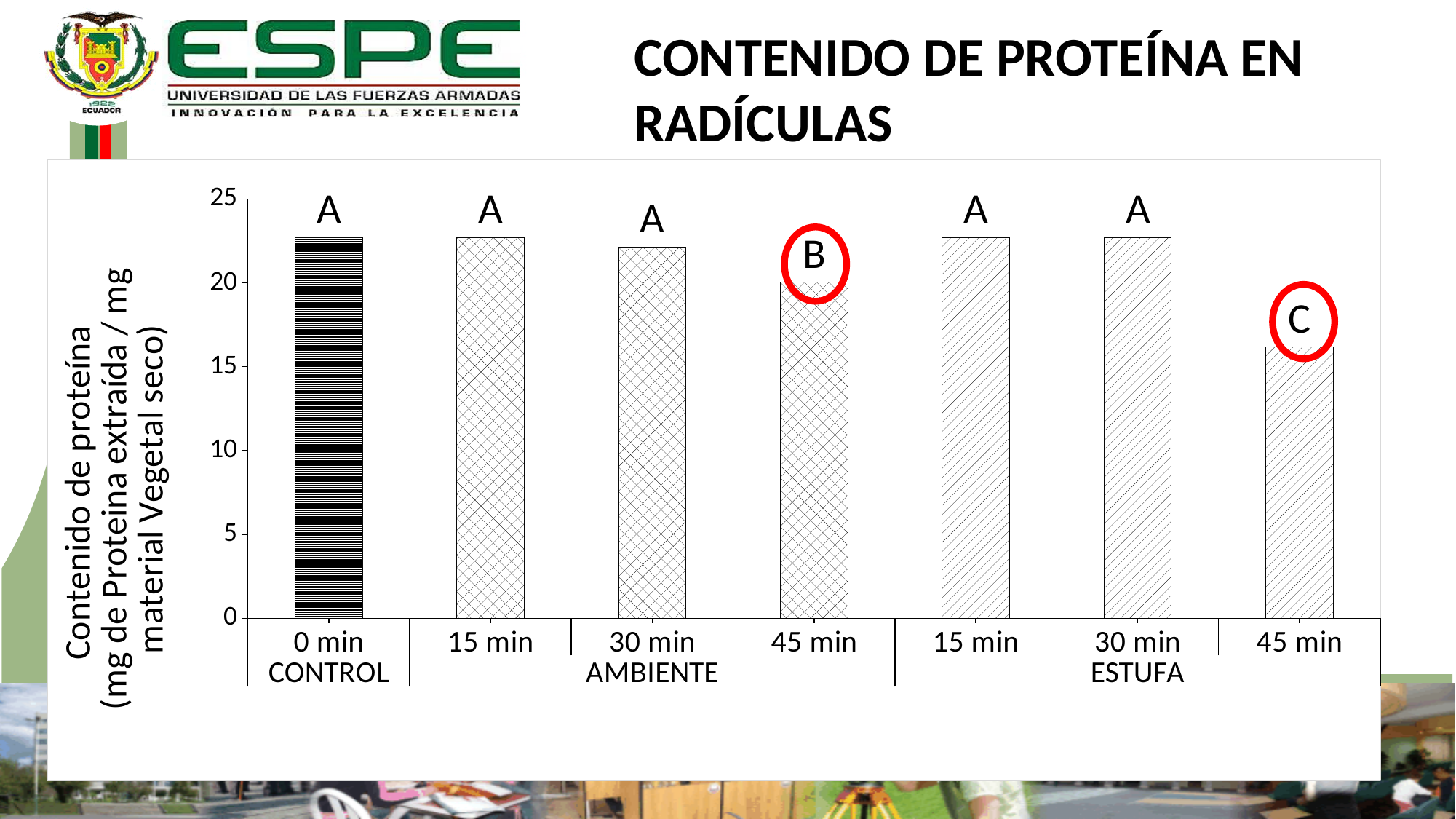
Which letter is printed above the 45 min ESTUFA bar? C Which bar has the lowest protein content? 45 min ESTUFA Which is larger, the value for 45 min AMBIENTE or the value for 45 min ESTUFA? 45 min AMBIENTE How many bars are plotted in the chart? 7 Which letter is printed above the 45 min AMBIENTE bar? B What kind of chart is shown on the slide? bar chart Is the value for 45 min ESTUFA greater or less than 20? less Is the value for 0 min CONTROL greater or less than 20? greater Within the ESTUFA group, do the values rise or fall from 15 min to 45 min? fall Is the value for 45 min AMBIENTE greater or less than 15? greater Which is larger, the value for 30 min AMBIENTE or the value for 45 min ESTUFA? 30 min AMBIENTE